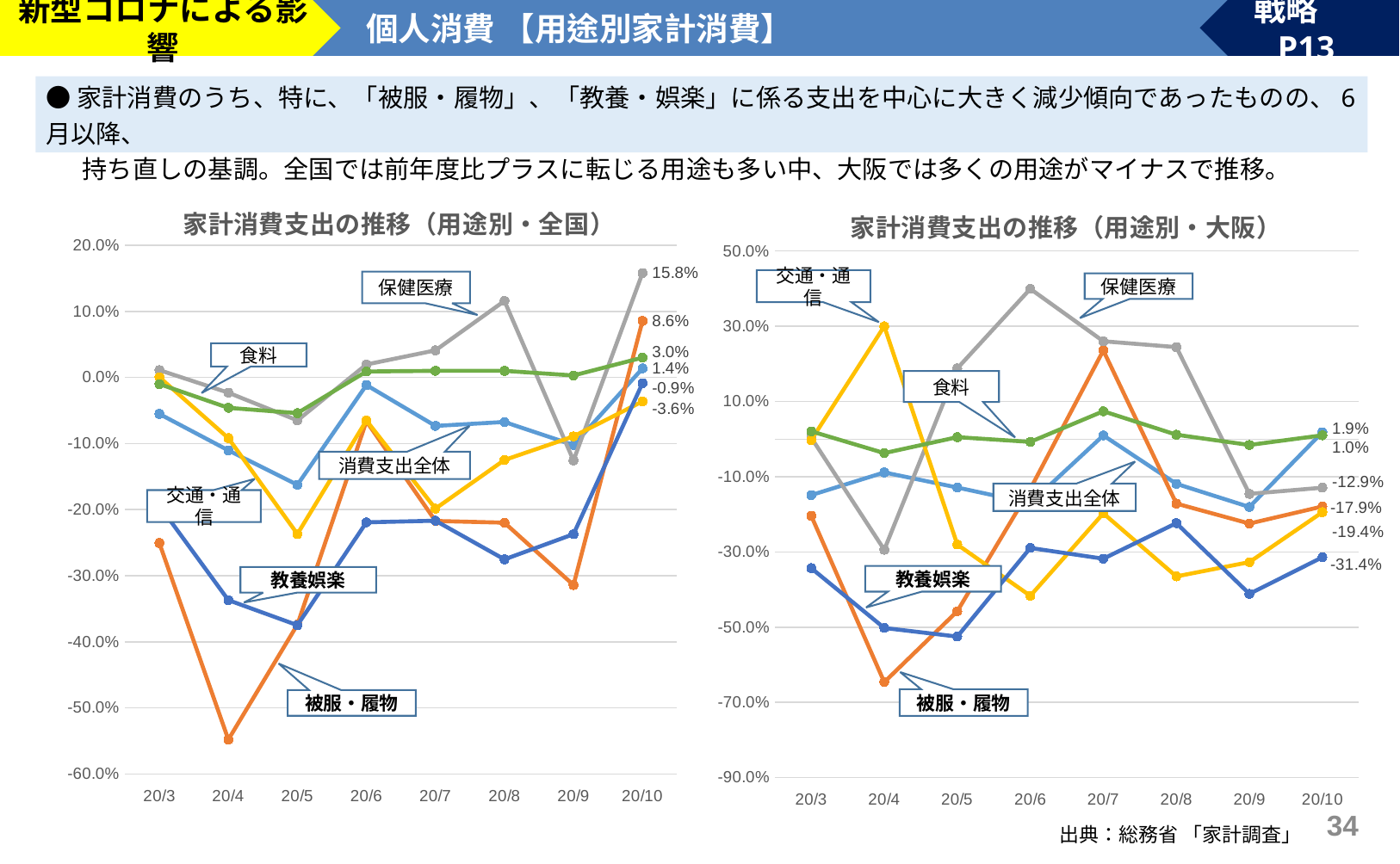
In the 家計消費支出の推移（用途別・大阪） chart, what is the value for 消費支出全体 at 20/10? 1.9% In the 家計消費支出の推移（用途別・大阪） chart, is the value for 交通・通信 at 20/4 greater or less than 20.0%? greater In the 家計消費支出の推移（用途別・全国） chart, what is the difference between 保健医療 and 被服・履物 at 20/10? 7.2 percentage points What kind of chart is used on this slide for 家計消費支出の推移（用途別・全国）? Line chart In the 家計消費支出の推移（用途別・全国） chart, what is the value for 保健医療 at 20/10? 15.8% In the 家計消費支出の推移（用途別・大阪） chart, which series has the lowest value at 20/10? 教養娯楽 In the 家計消費支出の推移（用途別・大阪） chart, what is the value for 教養娯楽 at 20/10? -31.4% In the 家計消費支出の推移（用途別・全国） chart, what is the value for 被服・履物 at 20/10? 8.6% In the 家計消費支出の推移（用途別・全国） chart, which series has the highest value at 20/10? 保健医療 In the 家計消費支出の推移（用途別・全国） chart, how many months are shown on the x axis? 8 In the 家計消費支出の推移（用途別・大阪） chart, which is larger at 20/10: 食料 or 保健医療? 食料 In the 家計消費支出の推移（用途別・全国） chart, is the value for 被服・履物 at 20/4 greater or less than -50.0%? less